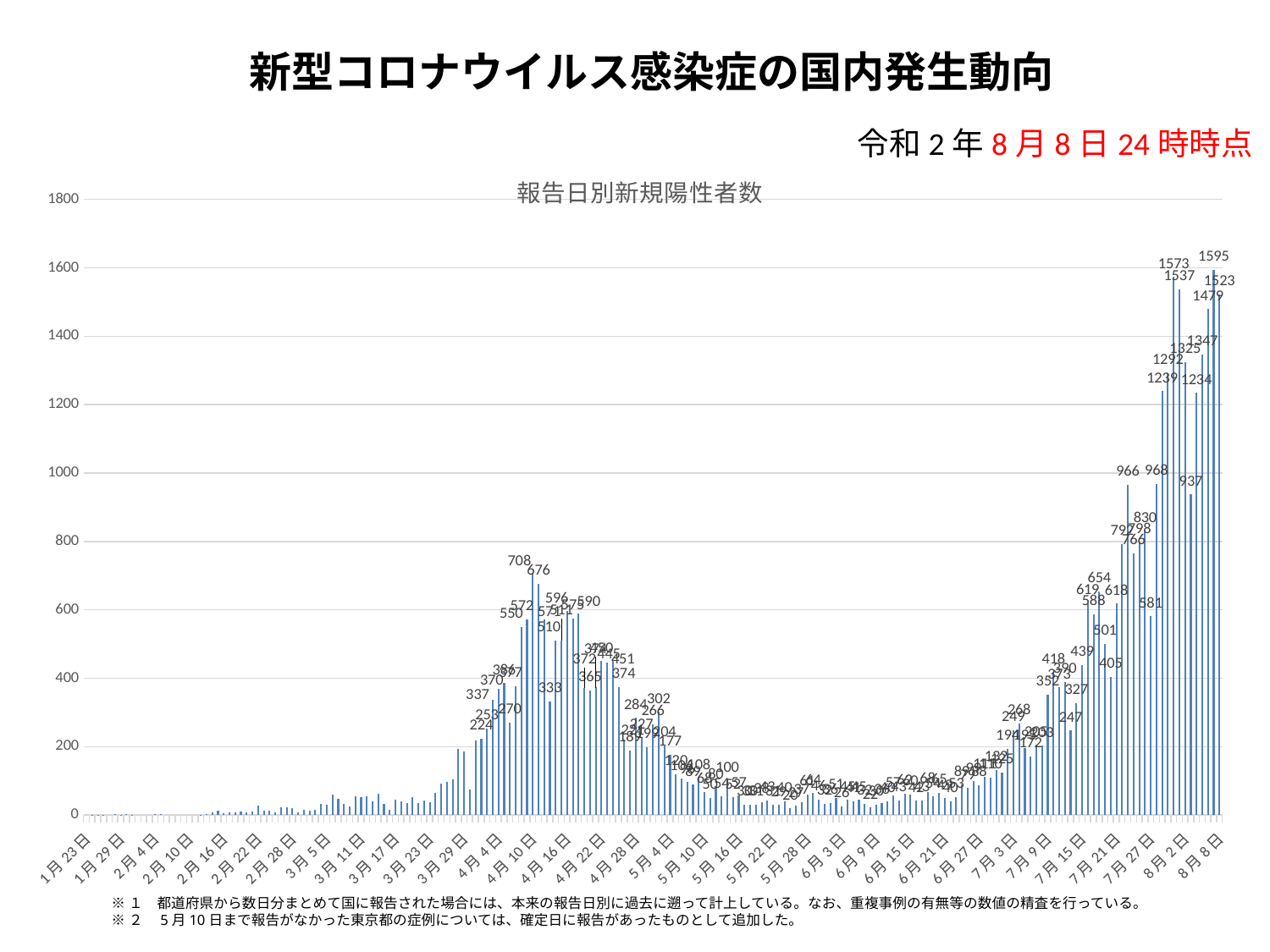
What is the highest daily value labelled on the chart? 1595 Do the values generally rise or fall between 5月4日 and 5月22日? fall Is the value for 1月23日 greater or less than 200? less Is the value for 5月22日 greater or less than 200? less What is the highest value labelled during the April peak of the chart? 708 Do the values generally rise or fall between 6月21日 and 8月8日? rise Which is larger: the April peak value of 708 or the August peak value of 1595? 1595 Is the value for 8月8日 greater or less than 1400? greater What is the difference between the highest labelled value in August (1595) and the highest labelled value in April (708)? 887 What is the title of the chart? 報告日別新規陽性者数 What kind of chart is shown on the slide? bar chart